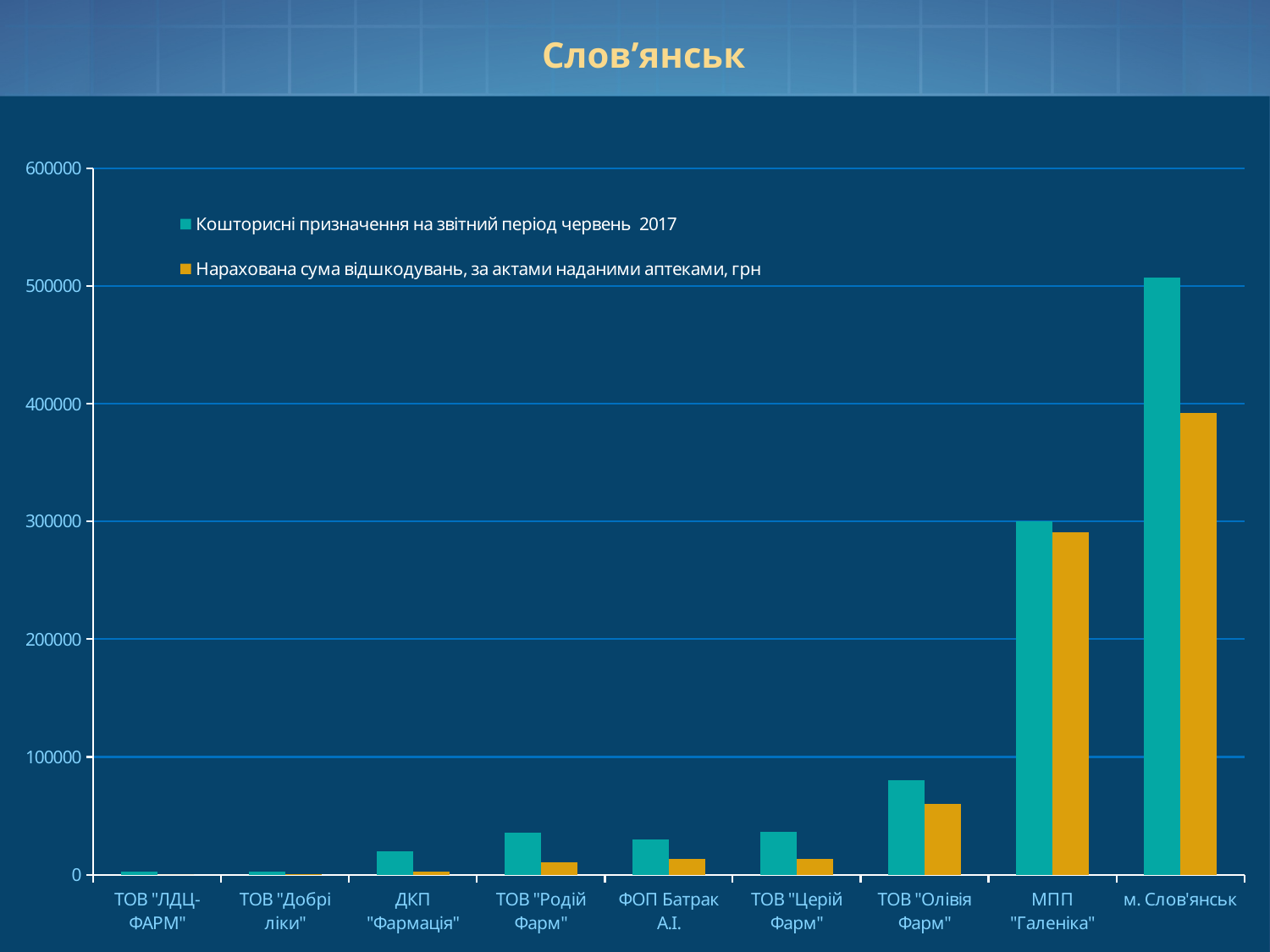
Which category has the highest value for the series "Нарахована сума відшкодувань, за актами наданими аптеками, грн"? м. Слов'янськ For the series "Кошторисні призначення на звітний період червень 2017", which is larger: ТОВ "Церій Фарм" or ТОВ "Олівія Фарм"? ТОВ "Олівія Фарм" Which category has the highest value for the series "Кошторисні призначення на звітний період червень 2017"? м. Слов'янськ How many categories are shown on the x axis? 9 For МПП "Галеніка", which series has the larger value: "Кошторисні призначення на звітний період червень 2017" or "Нарахована сума відшкодувань, за актами наданими аптеками, грн"? Кошторисні призначення на звітний період червень 2017 Is the value of "Кошторисні призначення на звітний період червень 2017" for ТОВ "Олівія Фарм" greater or less than 100000? less Is the value of "Нарахована сума відшкодувань, за актами наданими аптеками, грн" for МПП "Галеніка" greater or less than 300000? less Do the values of "Кошторисні призначення на звітний період червень 2017" generally rise or fall from left to right along the x axis? rise How many series does the legend list? 2 What is the title of the chart? Слов’янськ What kind of chart is shown on the slide? bar chart Is the value of "Нарахована сума відшкодувань, за актами наданими аптеками, грн" for м. Слов'янськ greater or less than 400000? less